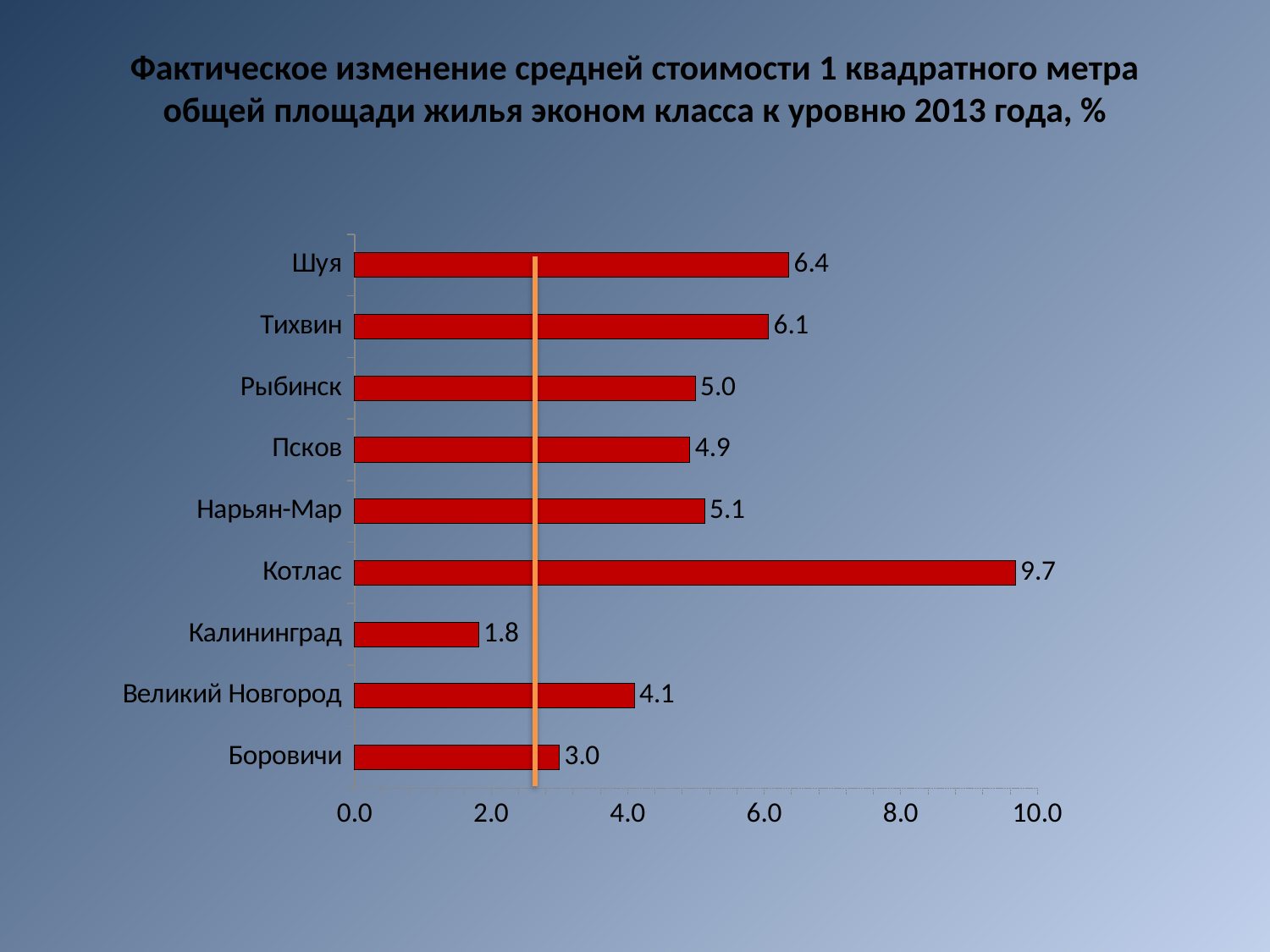
Which city has the highest value? Котлас How many cities are shown in the chart? 9 What is the value for Котлас? 9.7 What kind of chart is shown on the slide? bar chart What is the value for Калининград? 1.8 What colour are the bars in the chart? red Which city has the lowest value? Калининград What is the value for Шуя? 6.4 What is the difference between the values for Шуя and Тихвин? 0.3 Which is larger, the value for Рыбинск or the value for Боровичи? Рыбинск What is the difference between the values for Котлас and Калининград? 7.9 What is the value for Великий Новгород? 4.1